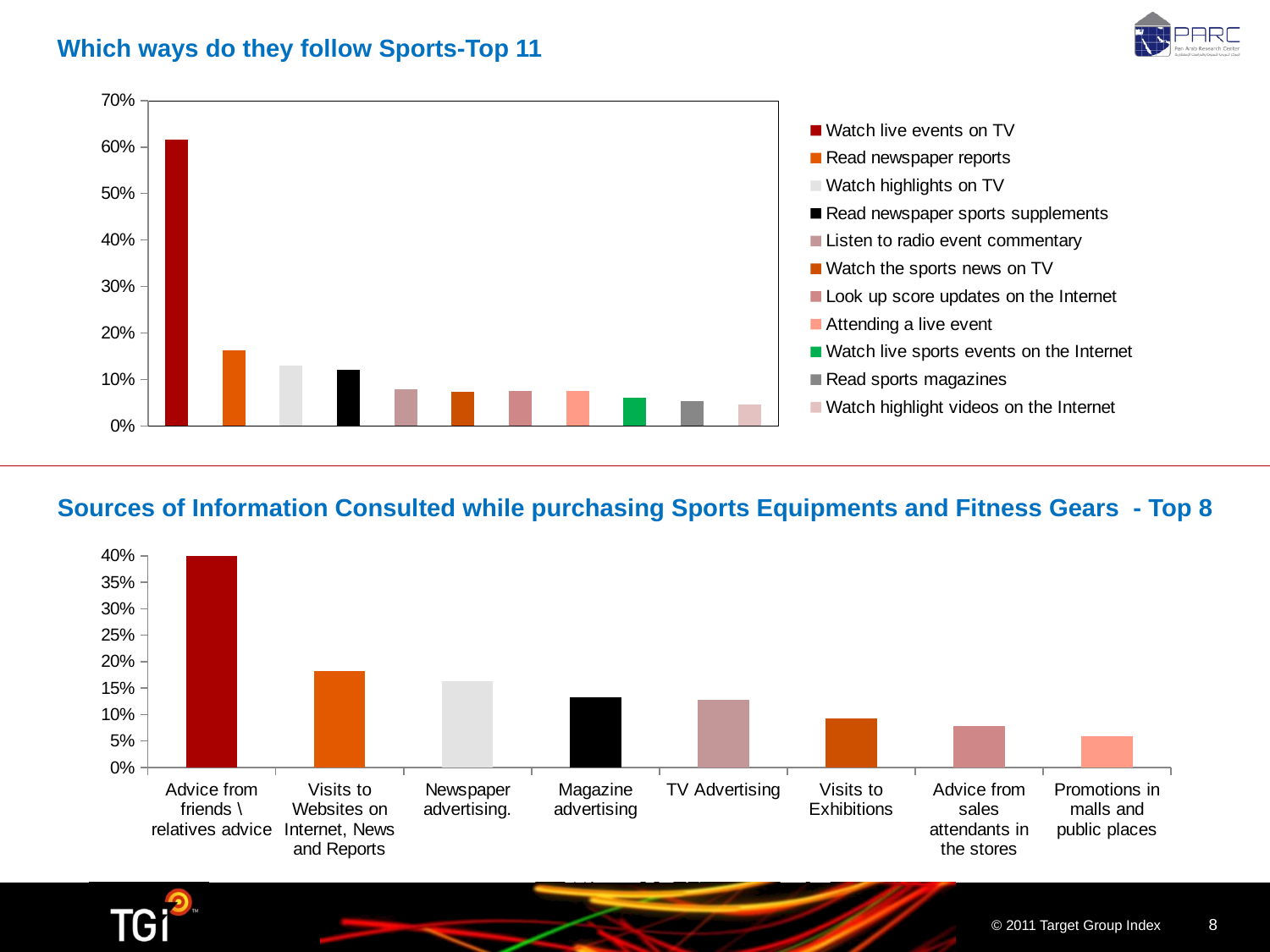
In the top chart "Which ways do they follow Sports-Top 11", is the value for Watch live events on TV greater or less than 60%? greater In the top chart "Which ways do they follow Sports-Top 11", which is larger: Read newspaper reports or Watch highlights on TV? Read newspaper reports In the top chart "Which ways do they follow Sports-Top 11", what colour is the bar for Watch live sports events on the Internet? green In the top chart "Which ways do they follow Sports-Top 11", which way of following sports has the lowest value? Watch highlight videos on the Internet In the top chart "Which ways do they follow Sports-Top 11", which way of following sports has the highest value? Watch live events on TV What kind of chart is the top chart titled "Which ways do they follow Sports-Top 11"? bar chart In the bottom chart "Sources of Information Consulted while purchasing Sports Equipments and Fitness Gears - Top 8", which source has the highest value? Advice from friends \ relatives advice In the bottom chart "Sources of Information Consulted while purchasing Sports Equipments and Fitness Gears - Top 8", how many categories are shown on the x axis? 8 In the top chart "Which ways do they follow Sports-Top 11", how many series does the legend list? 11 In the bottom chart "Sources of Information Consulted while purchasing Sports Equipments and Fitness Gears - Top 8", do the values rise or fall from left to right along the x axis? fall In the top chart "Which ways do they follow Sports-Top 11", is the value for Read newspaper reports greater or less than 20%? less In the bottom chart "Sources of Information Consulted while purchasing Sports Equipments and Fitness Gears - Top 8", which source has the lowest value? Promotions in malls and public places